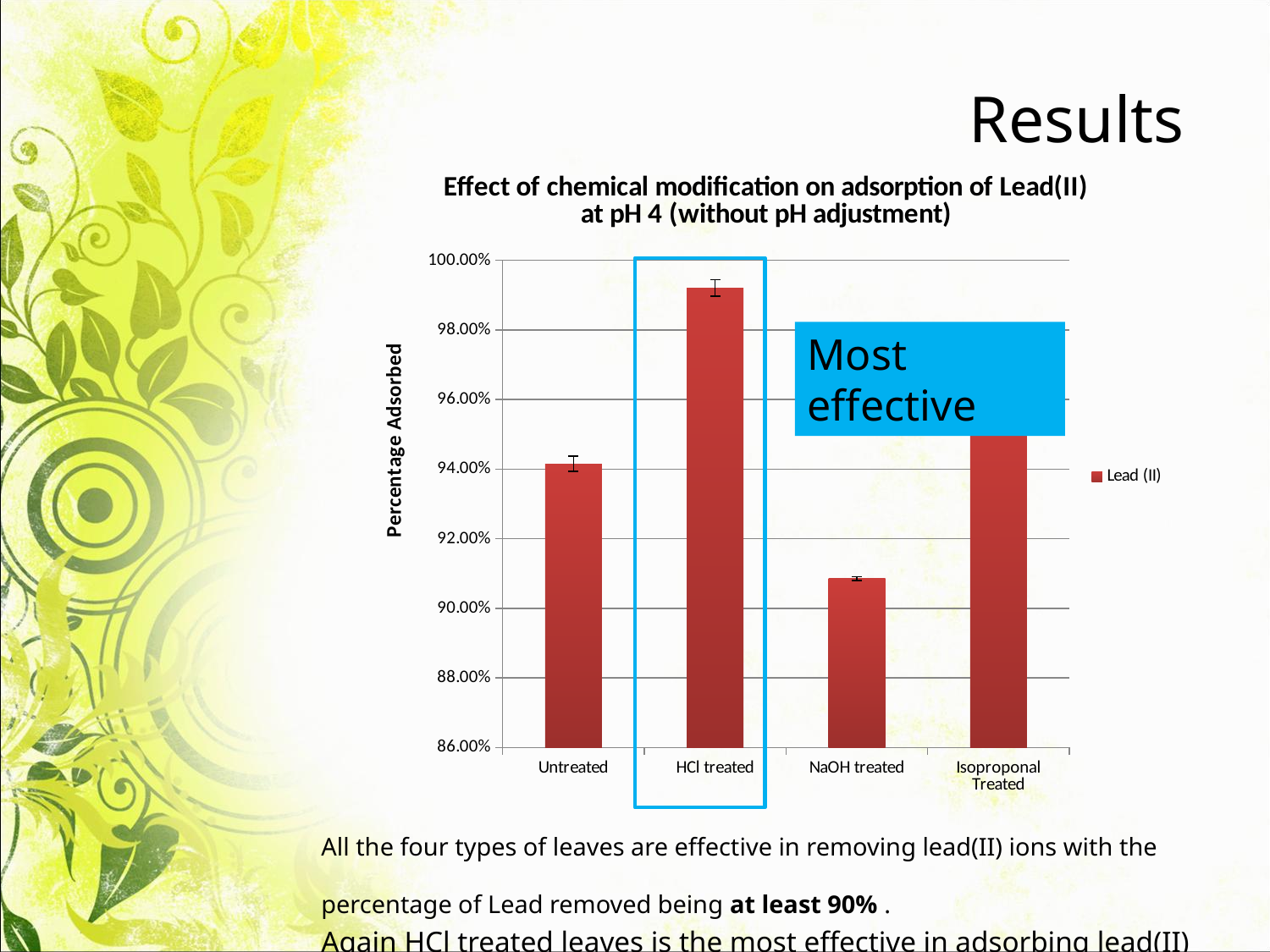
Is the value for NaOH treated greater or less than 92.00%? less How many series does the legend list? 1 How many treatment categories are plotted on the x axis? 4 Which treatment has the lowest percentage of Lead(II) adsorbed? NaOH treated What series name is shown in the legend? Lead (II) Is the value for HCl treated greater or less than 98.00%? greater Is the value for NaOH treated greater or less than 90.00%? greater Which is larger, the value for Untreated or the value for NaOH treated? Untreated What is the label of the y axis? Percentage Adsorbed What kind of chart is shown on the slide? Bar chart Which treatment has the highest percentage of Lead(II) adsorbed? HCl treated